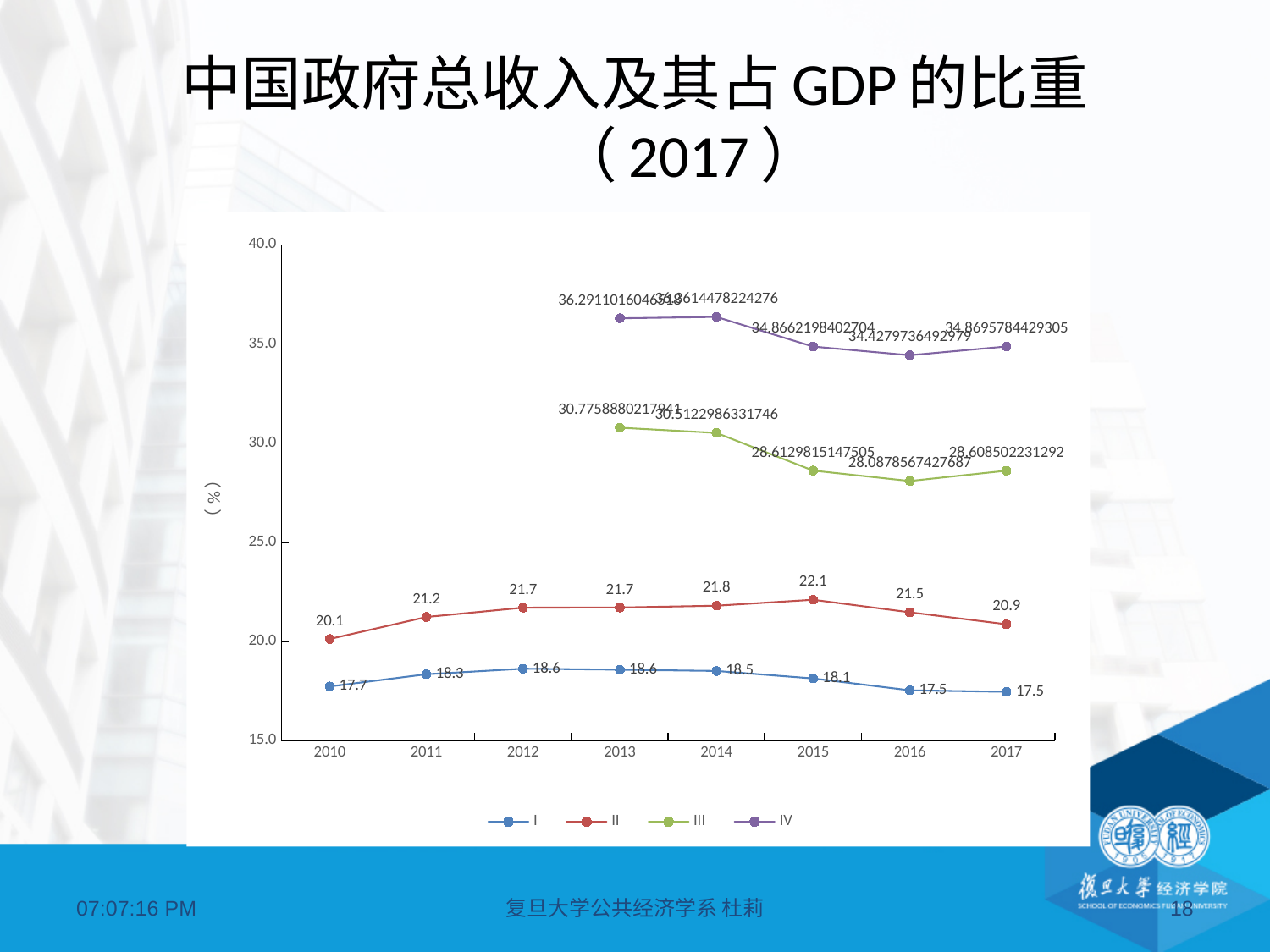
In which year is series II highest? 2015 How many series does the legend list? 4 How many years are shown on the x axis? 8 Is the value for series IV in 2016 greater or less than 35.0? less Which is larger in 2012: series I or series II? series II Is the value for series III in 2013 greater or less than 30.0? greater What kind of chart is shown on the slide? line chart What is the value of series I in 2010? 17.7 In which year is series I lowest? 2016 and 2017 What is the value of series II in 2015? 22.1 What is the value of series II in 2017? 20.9 What is the difference between series II and series I in 2015? 4.0